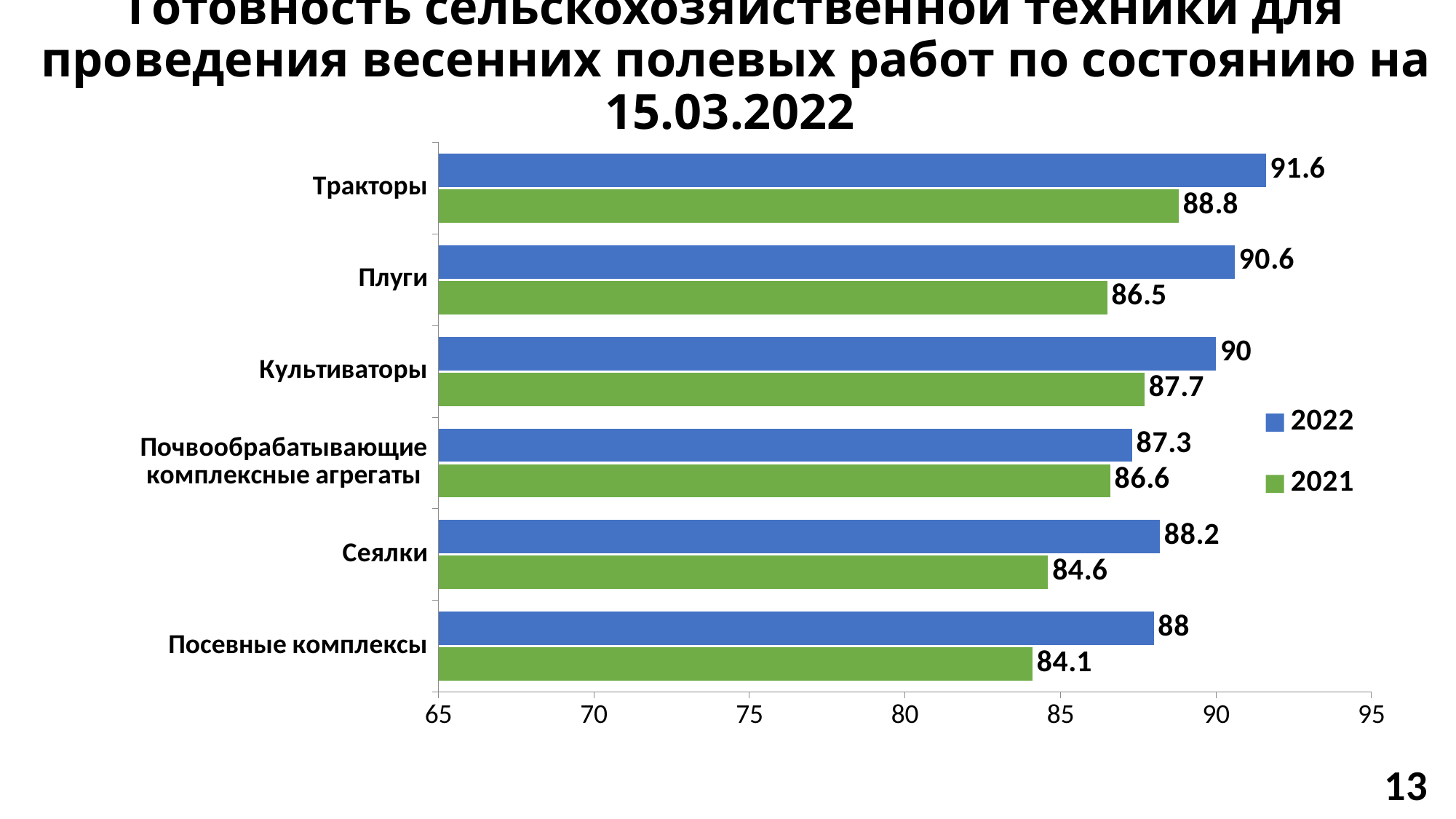
What is the 2022 value for Тракторы? 91.6 What is the difference between the 2022 and 2021 values for Плуги? 4.1 How many series does the legend list? 2 Which category has the highest 2022 value? Тракторы How many categories are shown on the chart? 6 Is the 2021 value for Тракторы greater or less than 85? greater Which is larger: the 2022 value for Культиваторы or the 2022 value for Сеялки? Культиваторы Which category has the lowest 2021 value? Посевные комплексы What is the difference between the 2022 and 2021 values for Посевные комплексы? 3.9 What is the 2021 value for Почвообрабатывающие комплексные агрегаты? 86.6 What is the 2021 value for Сеялки? 84.6 What kind of chart is shown on the slide? bar chart